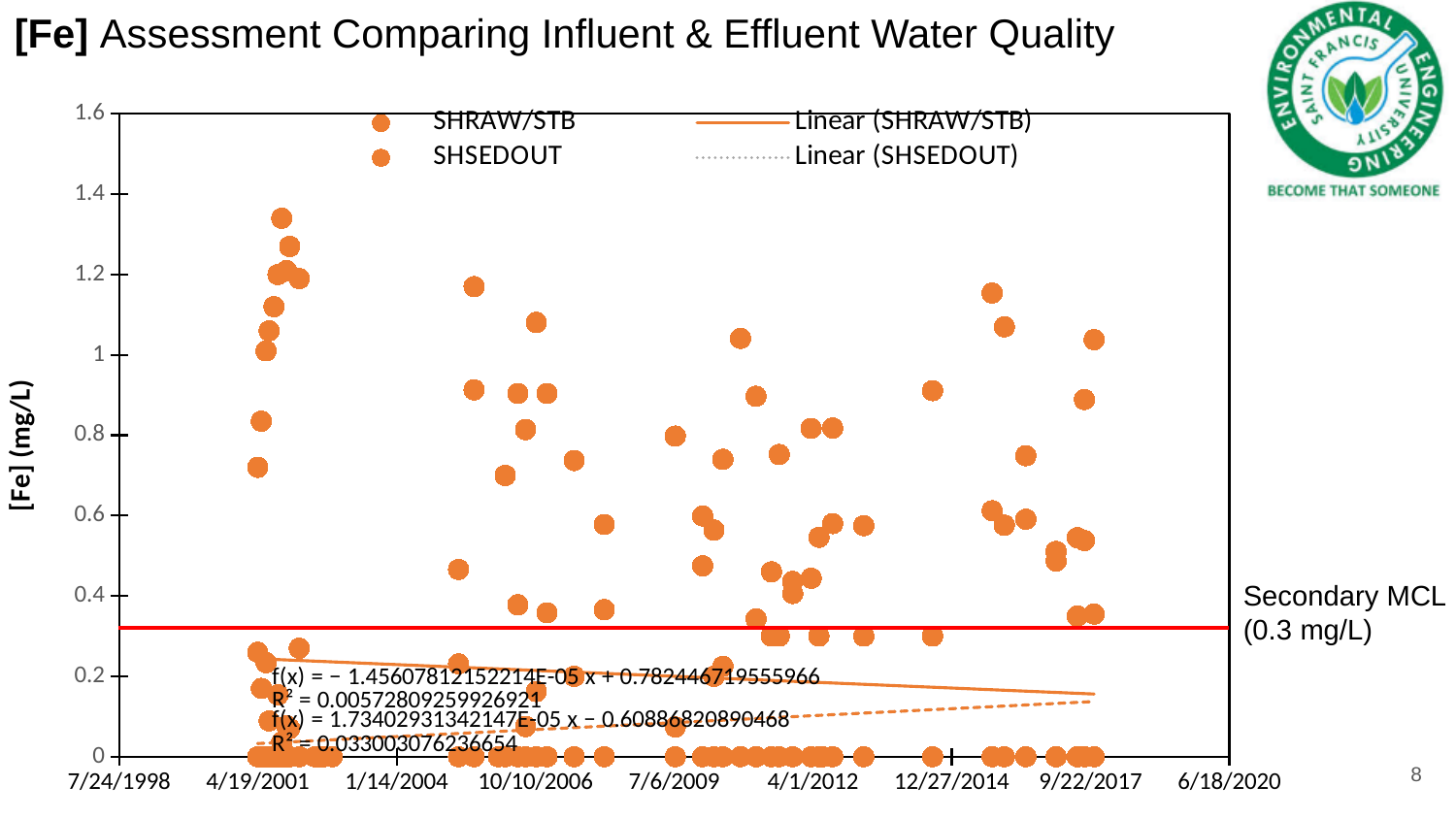
What is the maximum value shown on the y axis of the chart? 1.6 What kind of chart is shown on the slide? scatter chart What is the title of the chart? [Fe] Assessment Comparing Influent & Effluent Water Quality How many entries does the chart legend list? 4 What is the R² value printed for the Linear (SHSEDOUT) trendline? 0.0330030762366654 Does the Linear (SHRAW/STB) trendline rise or fall from left to right? fall What is the label on the y axis of the chart? [Fe] (mg/L) Does the Linear (SHSEDOUT) trendline rise or fall from left to right? rise How many data series (excluding the linear trendlines) does the legend list? 2 What concentration does the red Secondary MCL line mark? 0.3 mg/L What is the R² value printed for the Linear (SHRAW/STB) trendline? 0.00572809259926921 Is the highest plotted [Fe] value on the chart greater or less than 1.2? greater